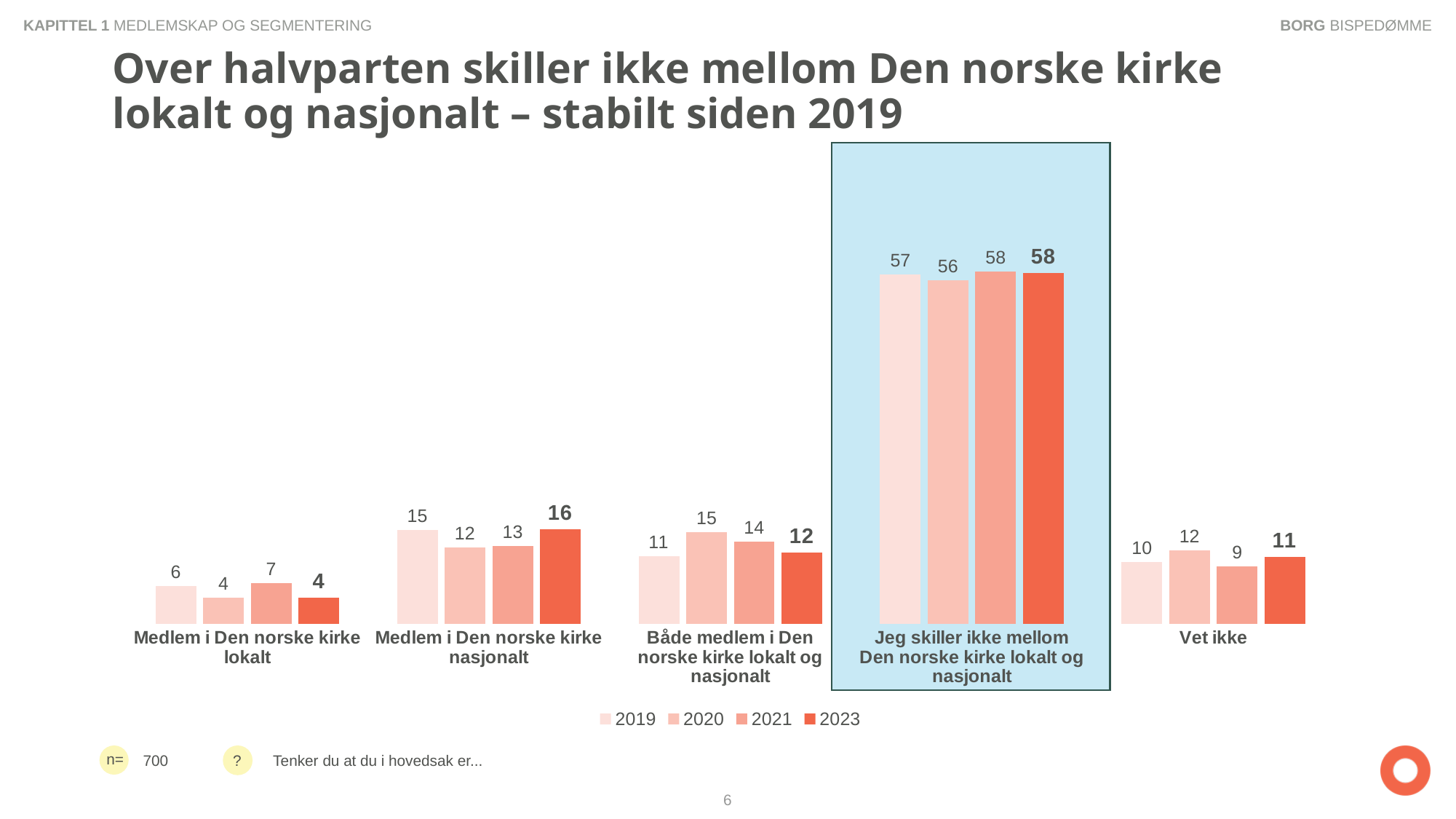
What is the 2020 value for "Vet ikke"? 12 Which category is highlighted with a blue box on the chart? Jeg skiller ikke mellom Den norske kirke lokalt og nasjonalt What is the 2023 value for "Jeg skiller ikke mellom Den norske kirke lokalt og nasjonalt"? 58 What is the difference between the 2023 and 2019 values for "Medlem i Den norske kirke lokalt"? 2 Which category has the highest 2023 value? Jeg skiller ikke mellom Den norske kirke lokalt og nasjonalt Which is larger for "Både medlem i Den norske kirke lokalt og nasjonalt": the 2020 value or the 2023 value? 2020 How many categories are shown on the x axis? 5 What is the 2019 value for "Medlem i Den norske kirke nasjonalt"? 15 Which category has the lowest 2023 value? Medlem i Den norske kirke lokalt How many series does the legend list? 4 What is the 2021 value for "Både medlem i Den norske kirke lokalt og nasjonalt"? 14 What kind of chart is shown on the slide? Bar chart